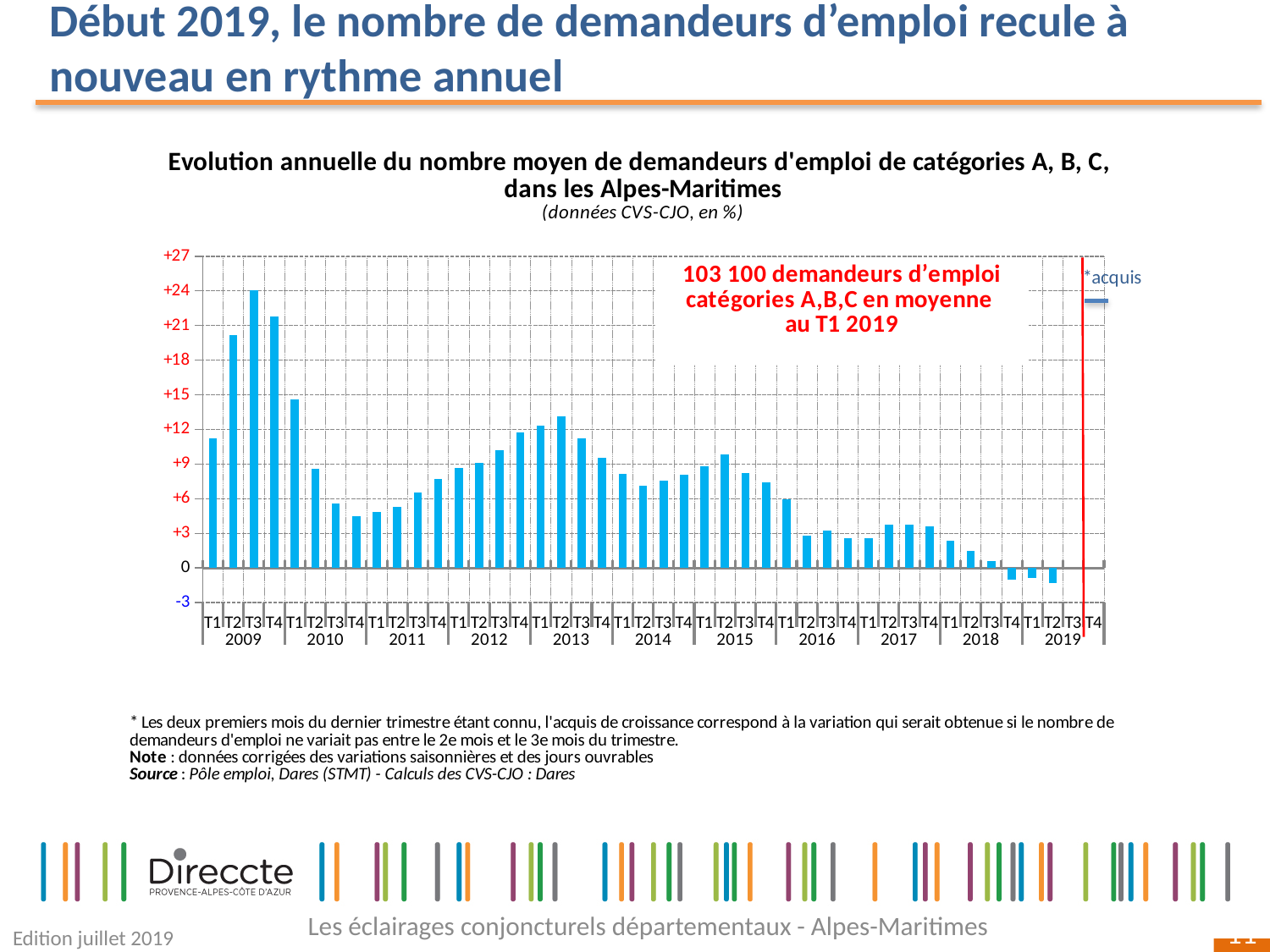
What kind of chart is shown on the slide? bar chart According to the red annotation on the chart, how many demandeurs d'emploi catégories A,B,C were there on average in T1 2019? 103 100 What is the value for T3 2009? +24 Is the value for T1 2009 greater or less than +9? greater How many years are labelled on the x axis? 11 Is the value for T2 2013 greater or less than +12? greater Is the value for T1 2019 greater or less than 0? less Which is larger, the value for T1 2012 or the value for T1 2018? T1 2012 Do the values rise or fall from T1 2017 to T1 2019? fall Which quarter has the highest annual evolution value in the chart? T3 2009 Which is larger, the value for T3 2009 or the value for T2 2013? T3 2009